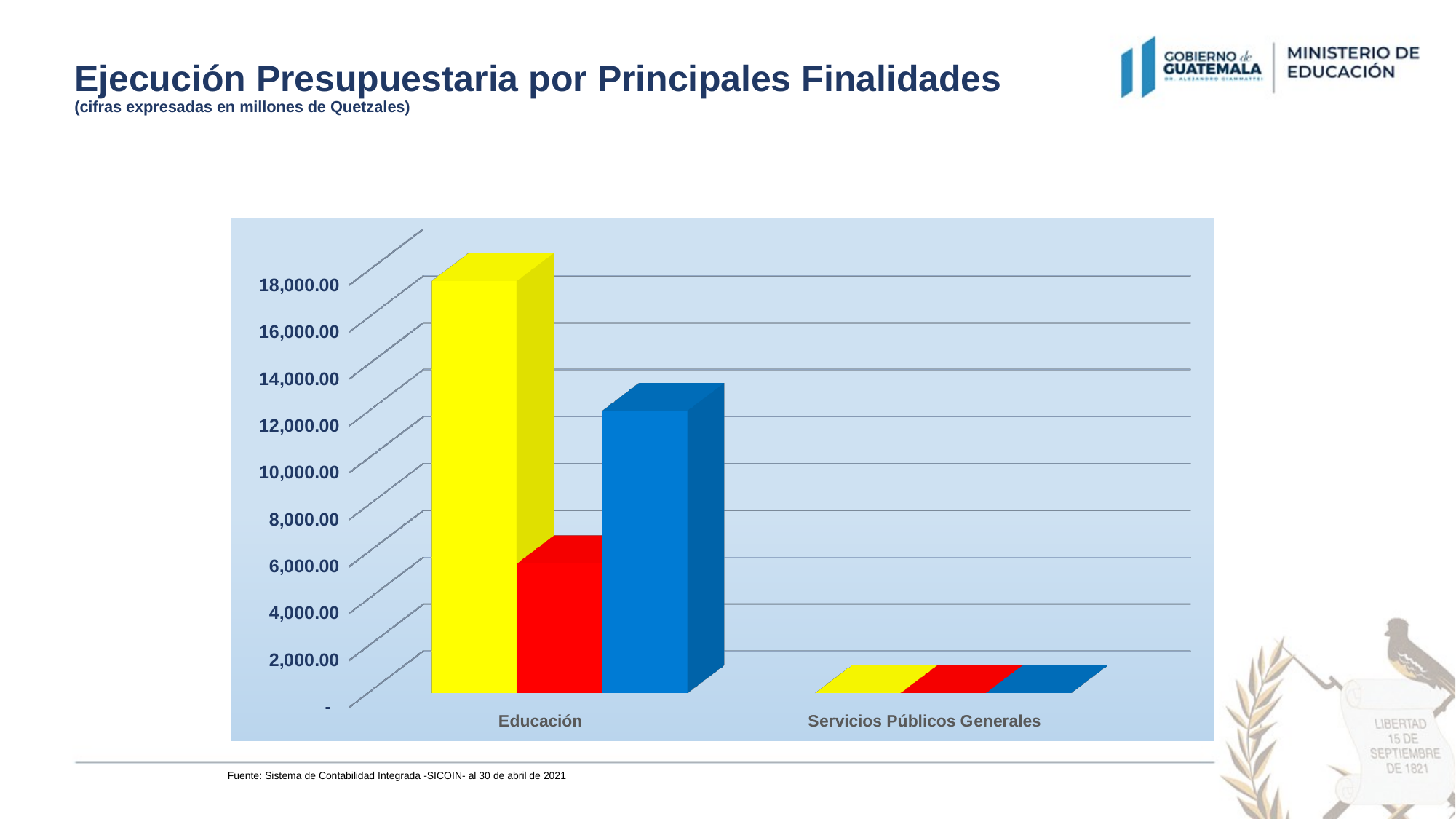
Is the value of the blue bar for Educación greater or less than 10,000.00? greater Are the values for Servicios Públicos Generales greater or less than 2,000.00? less Which category has the lowest bars in the chart? Servicios Públicos Generales In the Educación category, which bar is larger, the yellow one or the red one? The yellow one Is the value of the yellow bar for Educación greater or less than 14,000.00? greater Which category has the highest bars in the chart? Educación What kind of chart is shown on the slide? Bar chart How many bars are plotted for the Educación category? 3 In what units are the figures in the chart expressed, according to the subtitle? Millones de Quetzales What is the title of the slide containing the chart? Ejecución Presupuestaria por Principales Finalidades How many categories are shown on the x axis of the chart? 2